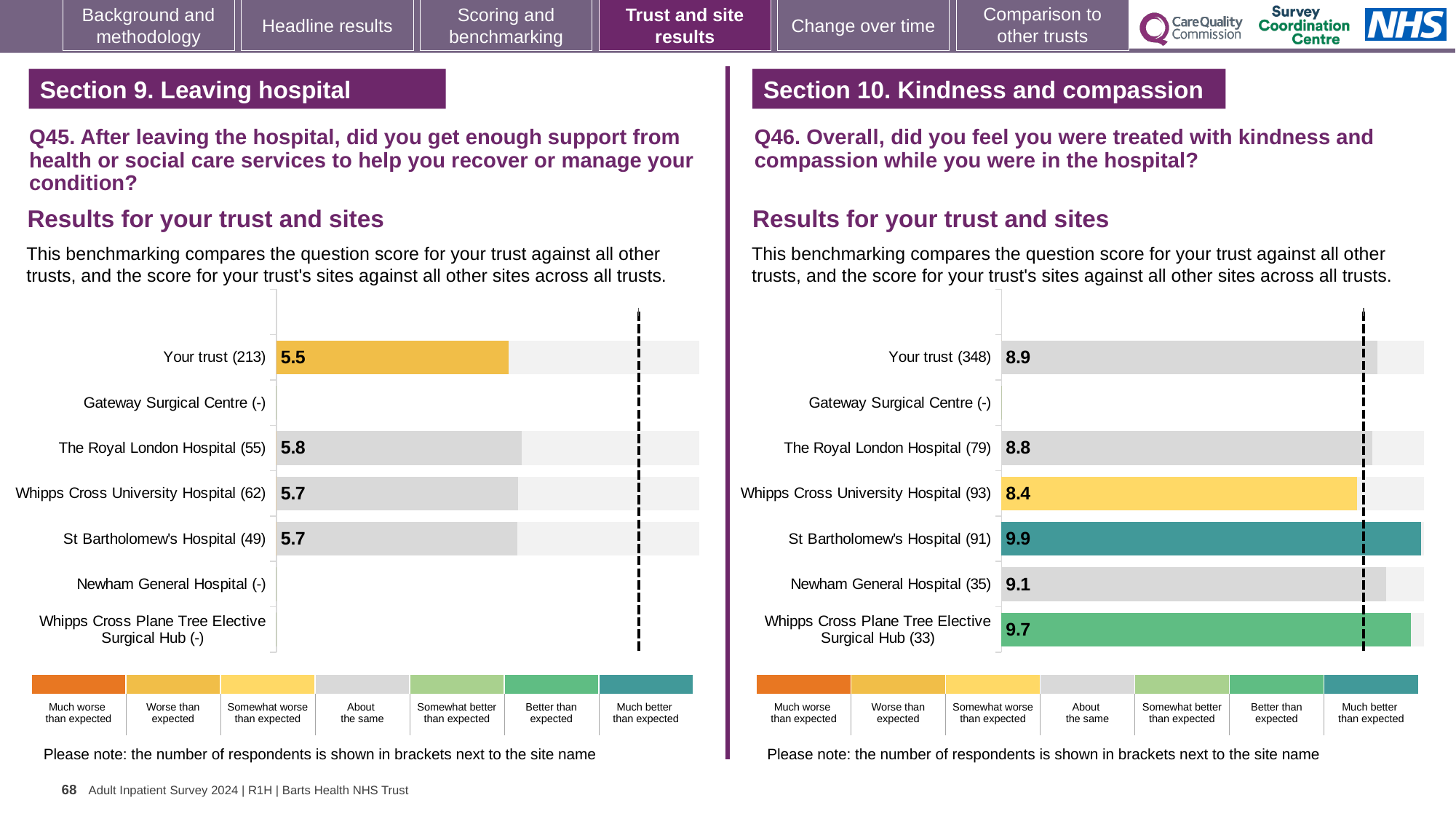
On the Q46 chart (right), what is the difference between the scores for St Bartholomew's Hospital and Your trust? 1.0 On the Q46 chart (right), which has the larger score: Newham General Hospital or The Royal London Hospital? Newham General Hospital On the Q46 chart (right), what is the score for Whipps Cross University Hospital? 8.4 On the Q46 chart (right), how many respondents are shown for Whipps Cross Plane Tree Elective Surgical Hub? 33 On the Q46 chart (right), which site has the lowest score? Whipps Cross University Hospital On the Q45 chart (left), which site with a printed score has the highest score? The Royal London Hospital On the Q45 chart (left), what is the difference between the scores for The Royal London Hospital and Your trust? 0.3 On the Q45 chart (left), what is the score for Your trust? 5.5 On the Q46 chart (right), which site has the highest score? St Bartholomew's Hospital On the Q45 chart (left), what is the score for The Royal London Hospital? 5.8 On the Q46 chart (right), what is the score for St Bartholomew's Hospital? 9.9 What type of chart is used on the Q46 chart (right)? Bar chart